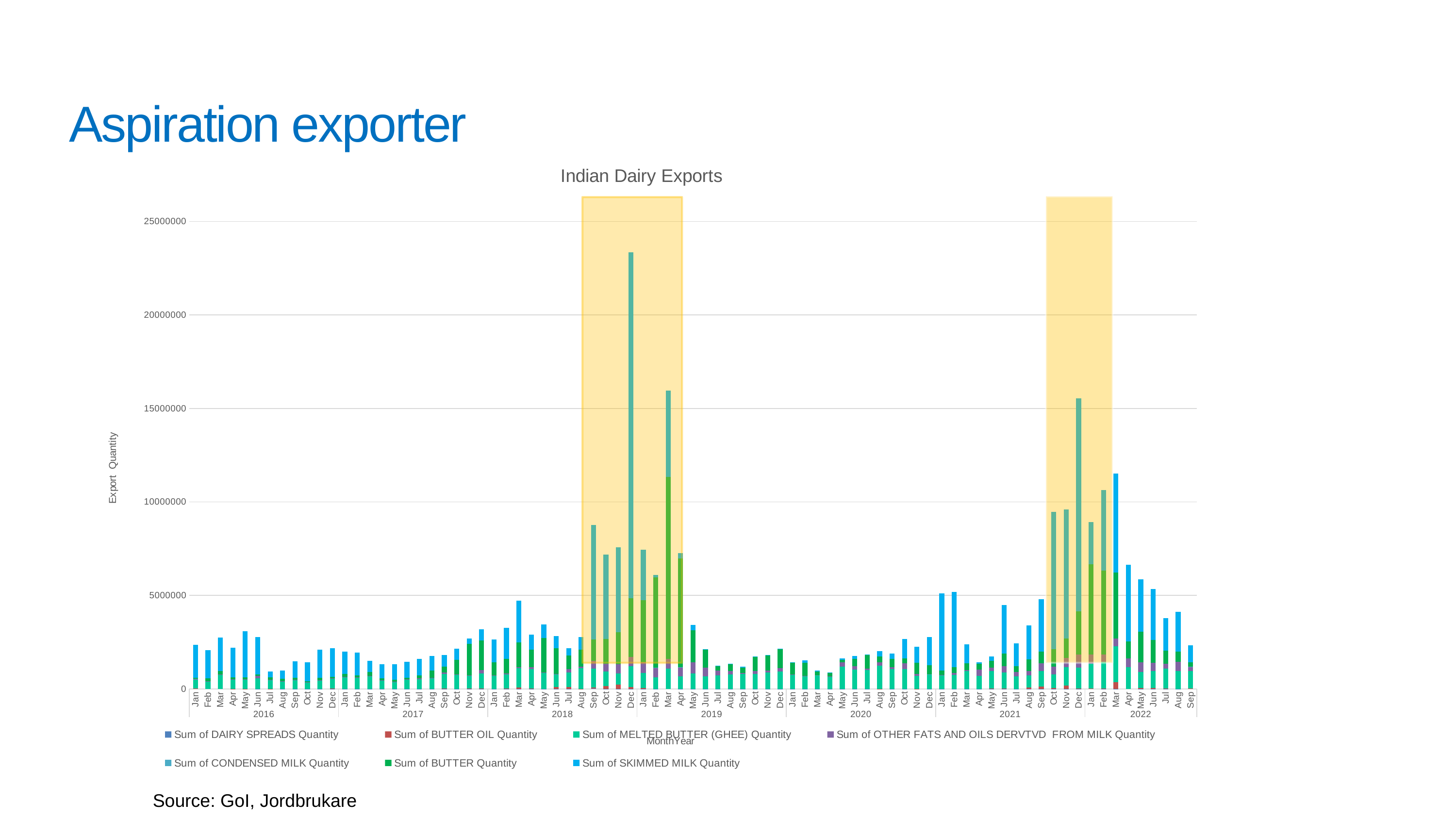
Is the total export quantity for Mar 2019 greater or less than 15000000? greater How many years are shown along the x axis? 7 How many series does the legend list? 7 Which month has the highest total export quantity? Dec 2018 Which month has the larger total export quantity, Dec 2018 or Mar 2019? Dec 2018 What is the label of the y axis? Export Quantity Which month has the larger total export quantity, Mar 2022 or Sep 2022? Mar 2022 What kind of chart is shown on the slide? Stacked bar chart Is the total export quantity for Dec 2018 greater or less than 20000000? greater Is the total export quantity for Jan 2016 greater or less than 5000000? less What is the title of the chart? Indian Dairy Exports